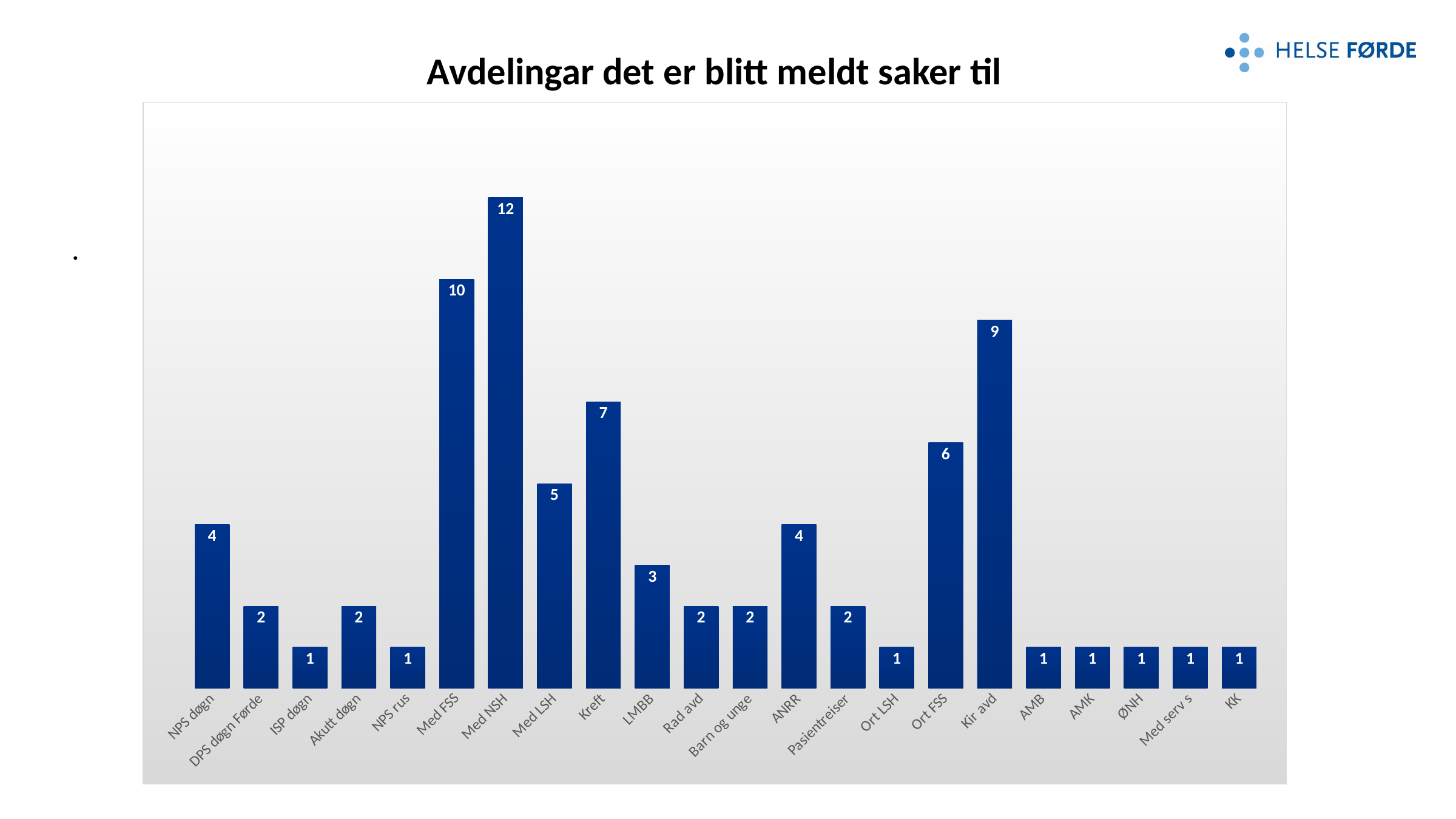
What is the value for Kreft? 7 How many categories are shown on the x axis? 22 What is the value for Kir avd? 9 What is the value for Med NSH? 12 What is the value for Ort FSS? 6 What is the title of the chart? Avdelingar det er blitt meldt saker til What is the difference between the values for Kir avd and Med LSH? 4 Which category has the highest value? Med NSH Which is larger, the value for Kreft or the value for Ort FSS? Kreft What is the difference between the values for Med NSH and Med FSS? 2 What kind of chart is shown on the slide? Bar chart Which is larger, the value for NPS døgn or the value for LMBB? NPS døgn